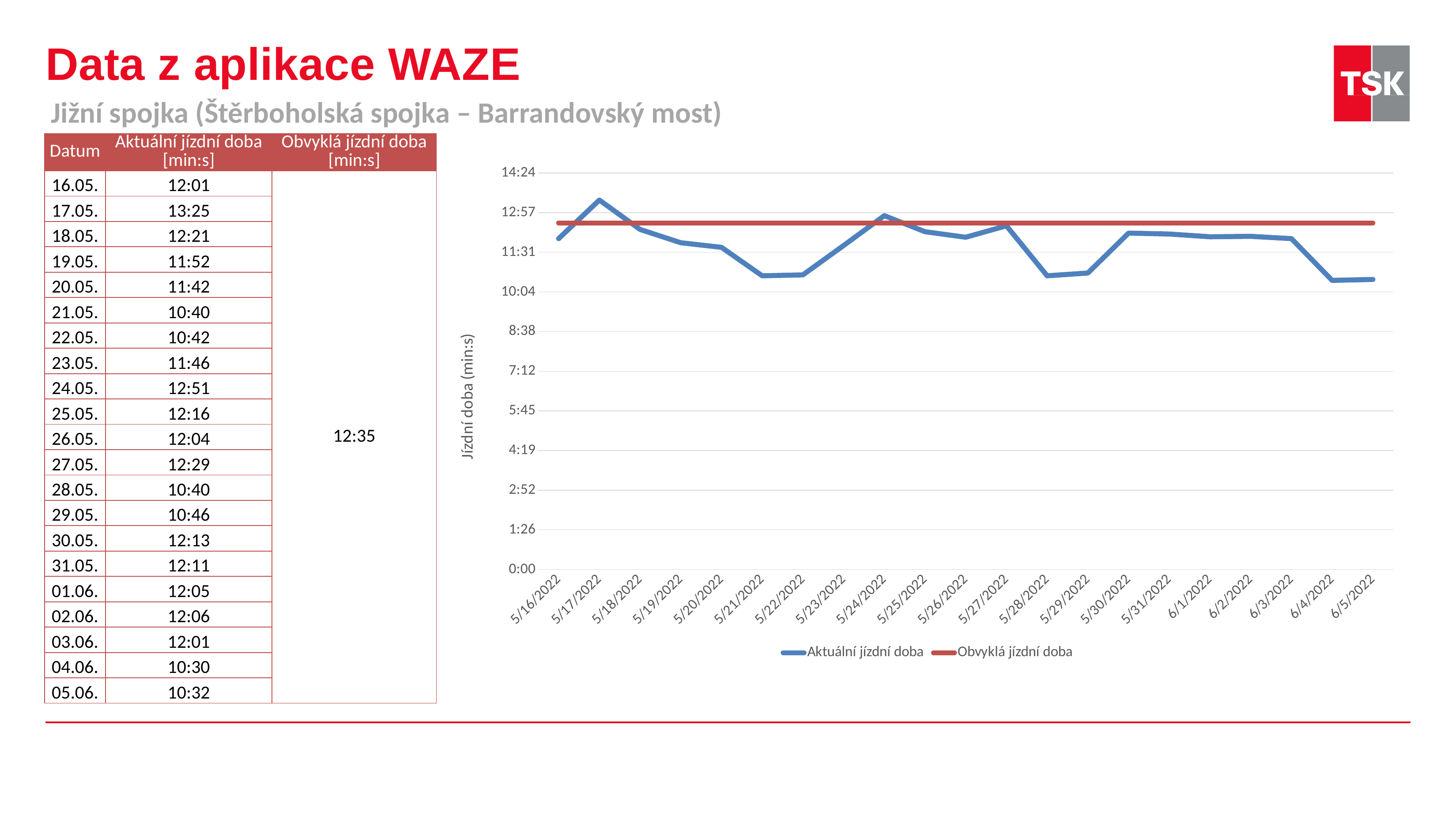
How many series does the chart legend list? 2 Does the Aktuální jízdní doba line rise or fall between 6/3/2022 and 6/4/2022? fall What kind of chart is shown on the slide? line chart On which date does the Aktuální jízdní doba line reach its highest value? 5/17/2022 On which date does the Aktuální jízdní doba line reach its lowest value? 6/4/2022 Which date has the larger Aktuální jízdní doba value, 5/24/2022 or 5/28/2022? 5/24/2022 Is the Aktuální jízdní doba value for 5/21/2022 greater or less than 11:31? less What is the value of the Obvyklá jízdní doba series shown as the flat line in the chart? 12:35 What is the label of the chart's vertical axis? Jízdní doba (min:s) What is the Aktuální jízdní doba value for 5/17/2022? 13:25 Is the Aktuální jízdní doba value for 5/17/2022 greater or less than 12:57? greater How many dates are plotted along the x axis of the chart? 21